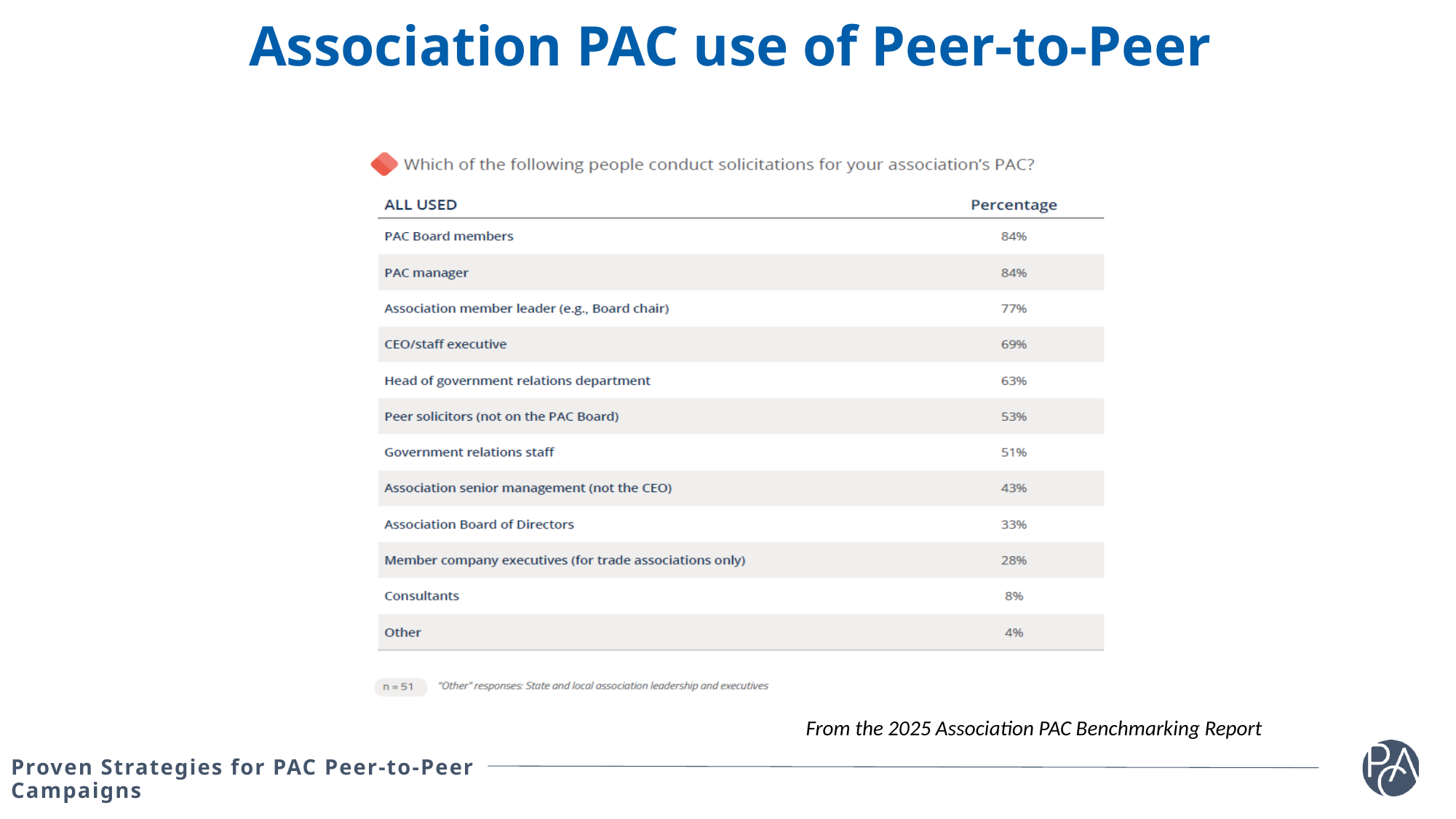
What is the difference in percentage between Head of government relations department and Government relations staff? 12% In the table, what percentage of associations use PAC Board members to conduct solicitations? 84% How many categories are listed in the table? 12 What is the difference in percentage between Association Board of Directors and Member company executives (for trade associations only)? 5% In the table, what is the percentage for CEO/staff executive? 69% In the table, what is the percentage for Consultants? 8% What question does the table answer, as shown in its heading? Which of the following people conduct solicitations for your association's PAC? In the table, what is the percentage for Peer solicitors (not on the PAC Board)? 53% Which category in the table has the lowest percentage? Other Which has a higher percentage: Association senior management (not the CEO) or Association member leader (e.g., Board chair)? Association member leader (e.g., Board chair) What is the sample size (n) shown below the table? n = 51 Which two categories in the table share the highest percentage? PAC Board members and PAC manager